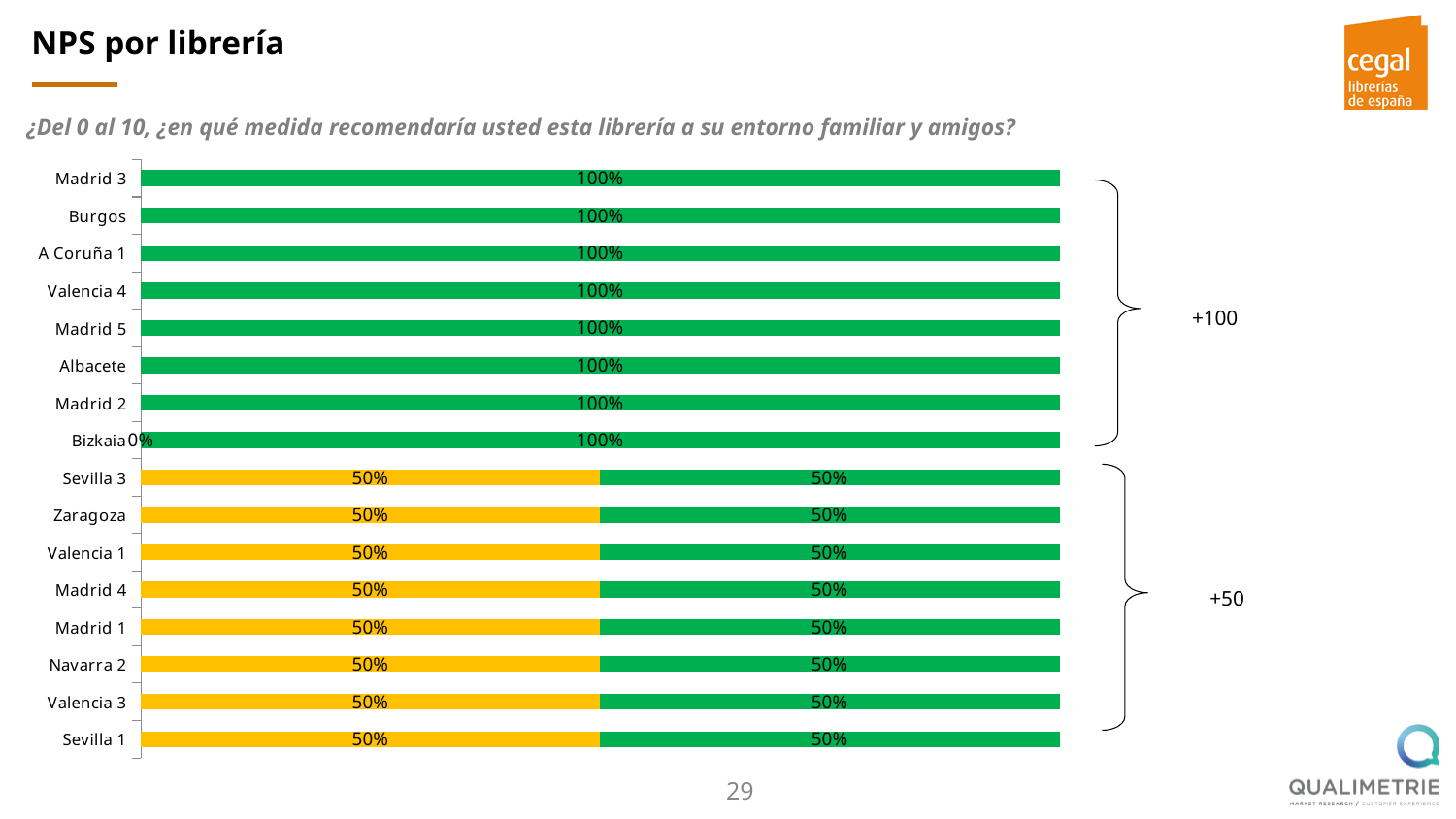
What is the value of the green segment for Madrid 3? 100% How many libraries (categories) are plotted in the chart? 16 What is the value of the green segment for Zaragoza? 50% Is the green segment for Valencia 1 greater or less than 100%? less What is the difference between the green segment for Burgos and the green segment for Sevilla 1? 50% What kind of chart is shown on the slide? bar chart What is the value of the green segment for Albacete? 100% What NPS value is indicated by the bracket next to the group from Sevilla 3 to Sevilla 1? +50 What is the value of the yellow segment for Sevilla 3? 50% Which is larger, the green segment for A Coruña 1 or the green segment for Navarra 2? A Coruña 1 What is the total of the stacked bar for Madrid 4? 100% What NPS value is indicated by the bracket next to the group from Madrid 3 to Bizkaia? +100